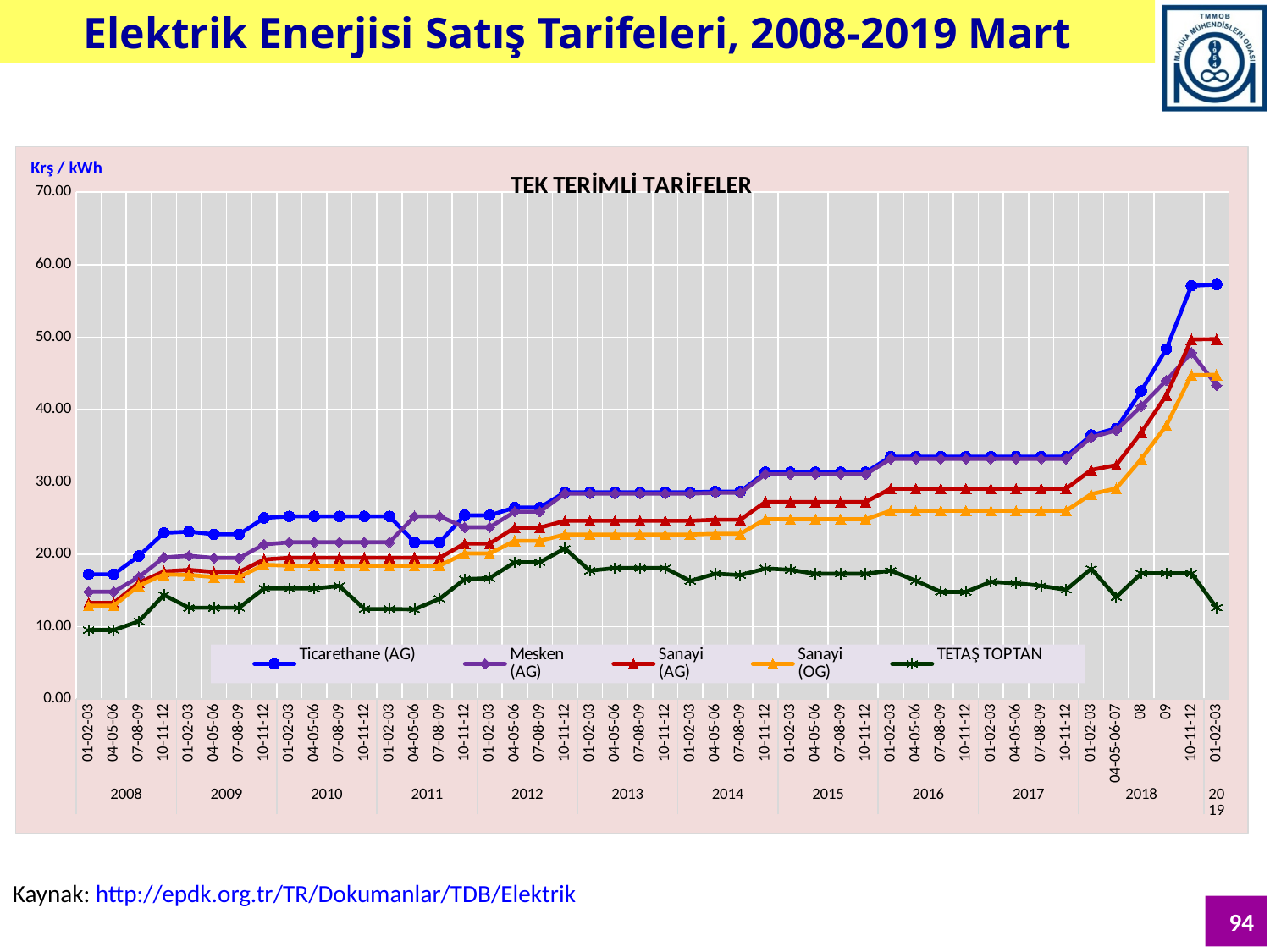
Which series are listed in the chart legend? Ticarethane (AG), Mesken (AG), Sanayi (AG), Sanayi (OG), TETAŞ TOPTAN How many series does the legend list? 5 What is the title printed inside the chart area? TEK TERİMLİ TARİFELER Is the value for TETAŞ TOPTAN at the last point (01-02-03 of 2019) greater or less than 20.00? less Is the value for Ticarethane (AG) at the last point (01-02-03 of 2019) greater or less than 50.00? greater At the last point (01-02-03 of 2019), which is larger: Ticarethane (AG) or Sanayi (OG)? Ticarethane (AG) How many year groups are labelled along the x axis? 12 Which series has the lowest value at the last point (01-02-03 of 2019)? TETAŞ TOPTAN Is the value for Sanayi (AG) at the last point (01-02-03 of 2019) greater or less than 40.00? greater What kind of chart is shown on the slide? line chart Which series has the highest value at the last point (01-02-03 of 2019)? Ticarethane (AG) Does the Ticarethane (AG) series generally rise or fall from 2008 to 2019? rise